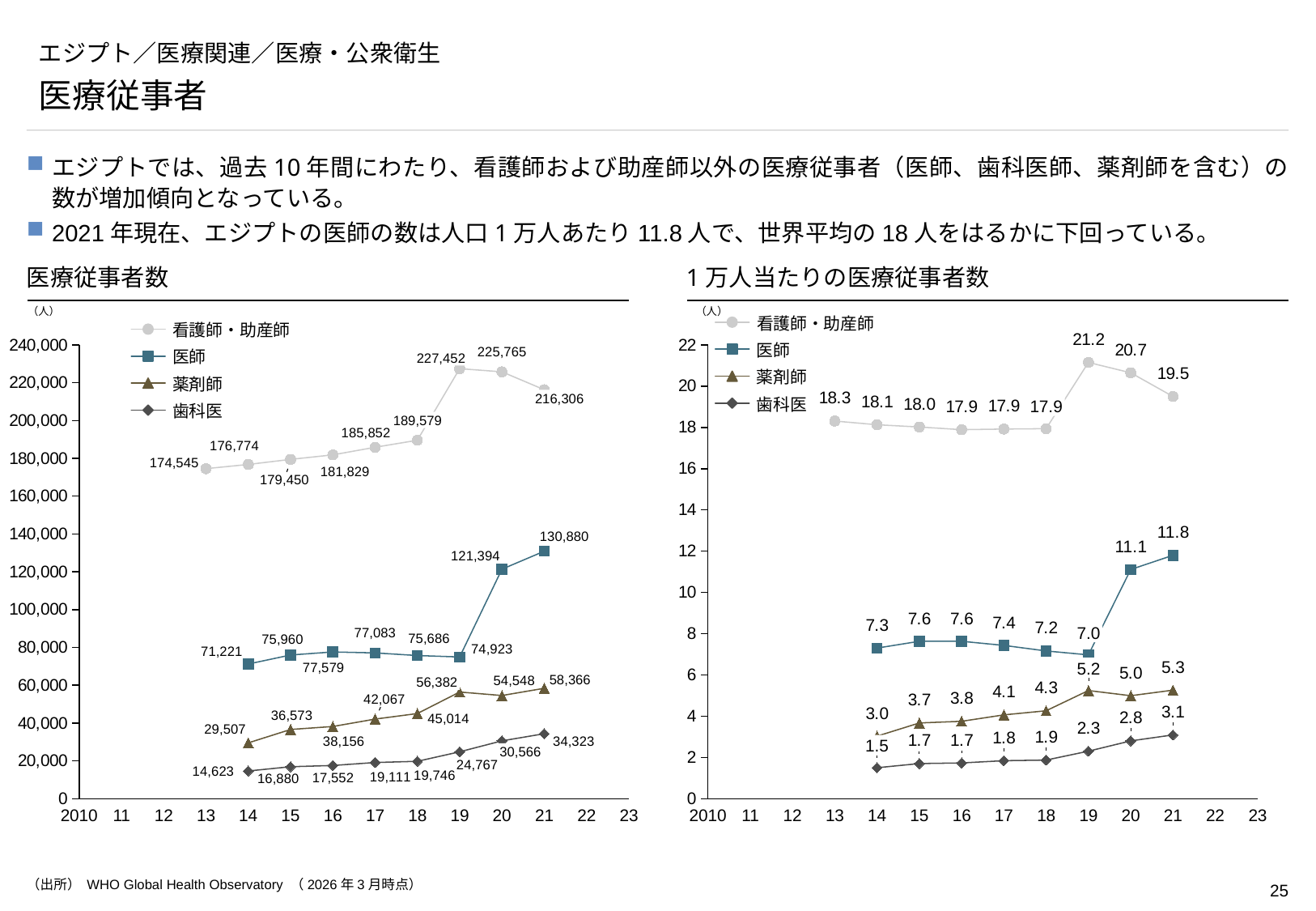
「医療従事者数」のグラフで、凡例にはいくつの系列がありますか？ 4 「1万人当たりの医療従事者数」のグラフで、2021年の医師の値はいくらですか？ 11.8 「医療従事者数」のグラフで、2014年の歯科医の数はいくらですか？ 14,623 「医療従事者数」のグラフで、2019年の看護師・助産師の数はいくらですか？ 227,452 「1万人当たりの医療従事者数」のグラフで、2014年の薬剤師の値はいくらですか？ 3.0 「1万人当たりの医療従事者数」のグラフで、歯科医の値は2014年から2021年にかけて上昇していますか、下降していますか？ 上昇 「医療従事者数」のグラフで、2021年の医師の数はいくらですか？ 130,880 「1万人当たりの医療従事者数」のグラフで、2020年の医師と薬剤師ではどちらの値が大きいですか？ 医師 「医療従事者数」のグラフはどの種類のグラフですか？ 折れ線グラフ 「1万人当たりの医療従事者数」のグラフで、2019年の看護師・助産師の値はいくらですか？ 21.2 「医療従事者数」のグラフで、看護師・助産師の数が最も多いのは何年ですか？ 2019年 「医療従事者数」のグラフで、2021年の薬剤師の数と2020年の薬剤師の数の差はいくらですか？ 3,818